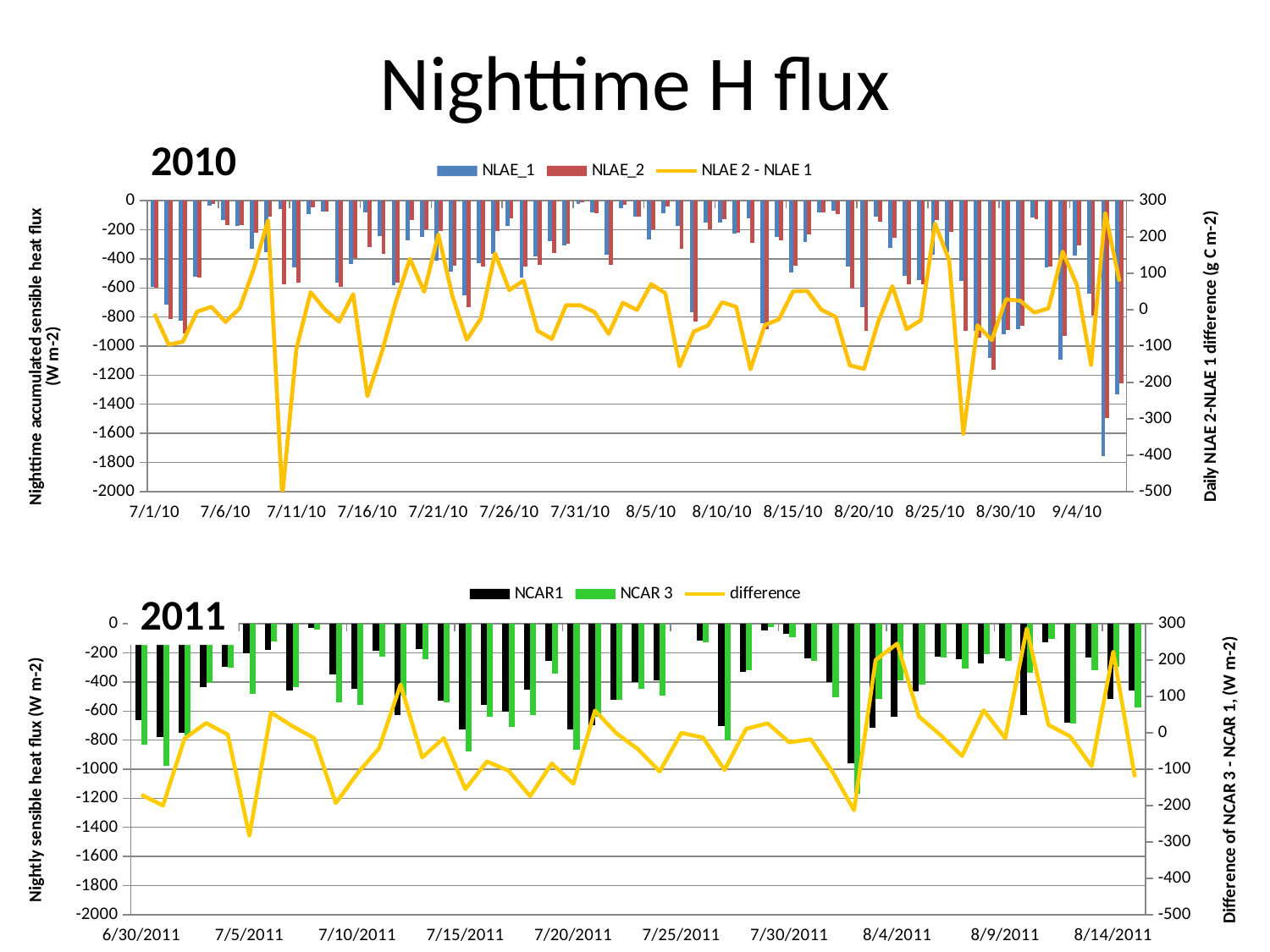
In the 2011 chart, is the lowest value of the difference line greater or less than -200 on the right axis? less How many series does the legend of the 2011 chart list? 3 In the 2011 chart, what kind of chart is used to plot the difference series? line chart What are the names of the two bar series in the 2011 chart's legend? NCAR1 and NCAR 3 In the 2010 chart, what kind of chart is used to plot NLAE_1 and NLAE_2? bar chart In the 2011 chart, is the highest value of the difference line greater or less than 200 on the right axis? greater How many date labels are shown on the x axis of the 2011 chart? 10 In the 2010 chart, is the lowest value of the NLAE 2 - NLAE 1 line greater or less than -400 on the right axis? less How many series does the legend of the 2010 chart list? 3 In the 2010 chart, in which month does the NLAE 2 - NLAE 1 line reach its lowest value? July